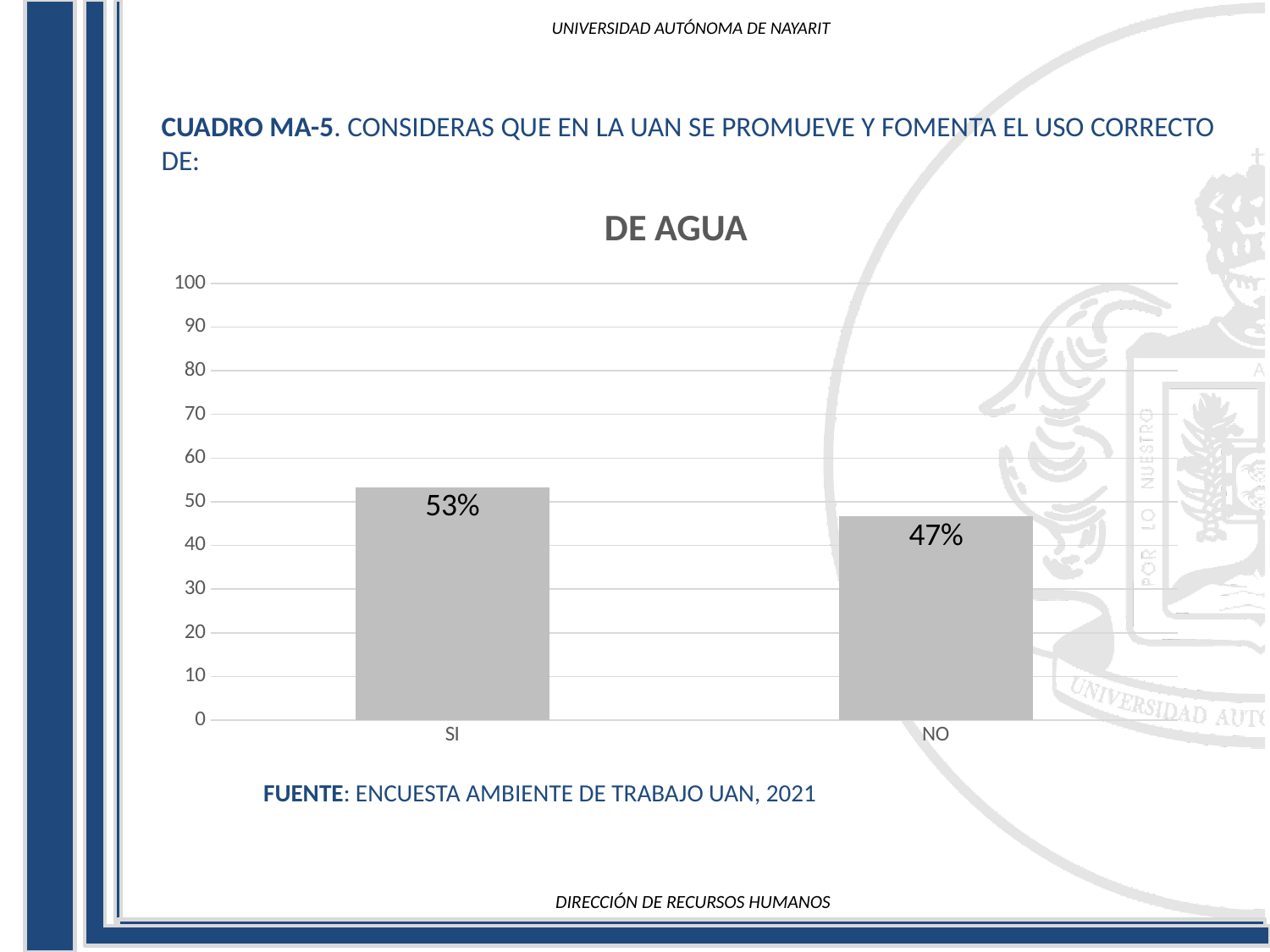
What is the difference between the values for SI and NO? 6% What kind of chart is shown? bar chart What is the title of the chart? DE AGUA What is the value for NO? 47% Which category has the highest value? SI Which category has the lowest value? NO Which is larger, the value for SI or the value for NO? SI Is the value for NO greater or less than 50? less What is the value for SI? 53% What is the maximum value shown on the y axis? 100 How many categories are shown on the x axis? 2 Is the value for SI greater or less than 50? greater